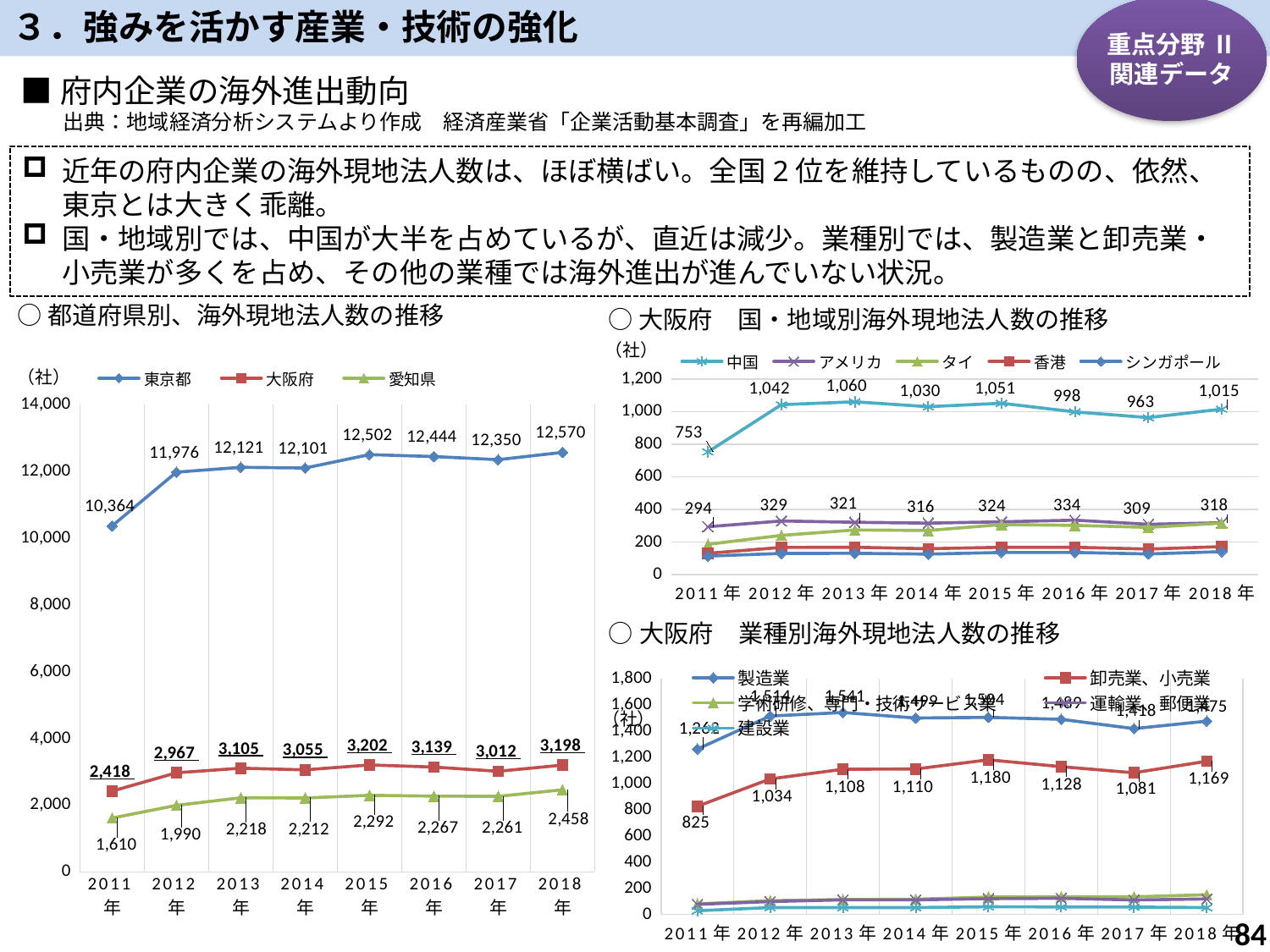
In the chart titled 都道府県別、海外現地法人数の推移, what is the value for 東京都 in 2018年? 12,570 In the chart titled 大阪府 業種別海外現地法人数の推移, what is the value for 卸売業、小売業 in 2015年? 1,180 In the chart titled 都道府県別、海外現地法人数の推移, how many series does the legend list? 3 In the chart titled 大阪府 国・地域別海外現地法人数の推移, how many series does the legend list? 5 In the chart titled 都道府県別、海外現地法人数の推移, what is the value for 大阪府 in 2015年? 3,202 In the chart titled 大阪府 業種別海外現地法人数の推移, in which year is the value for 卸売業、小売業 lowest? 2011年 In the chart titled 大阪府 国・地域別海外現地法人数の推移, what is the difference between the 中国 values in 2013年 and 2017年? 97 In the chart titled 大阪府 国・地域別海外現地法人数の推移, what is the value for 中国 in 2011年? 753 What kind of chart is the chart titled 都道府県別、海外現地法人数の推移? line chart In the chart titled 大阪府 国・地域別海外現地法人数の推移, in which year is the value for アメリカ highest? 2016年 In the chart titled 都道府県別、海外現地法人数の推移, in which year is the value for 愛知県 highest? 2018年 In the chart titled 都道府県別、海外現地法人数の推移, what is the difference between 大阪府 and 愛知県 in 2011年? 808